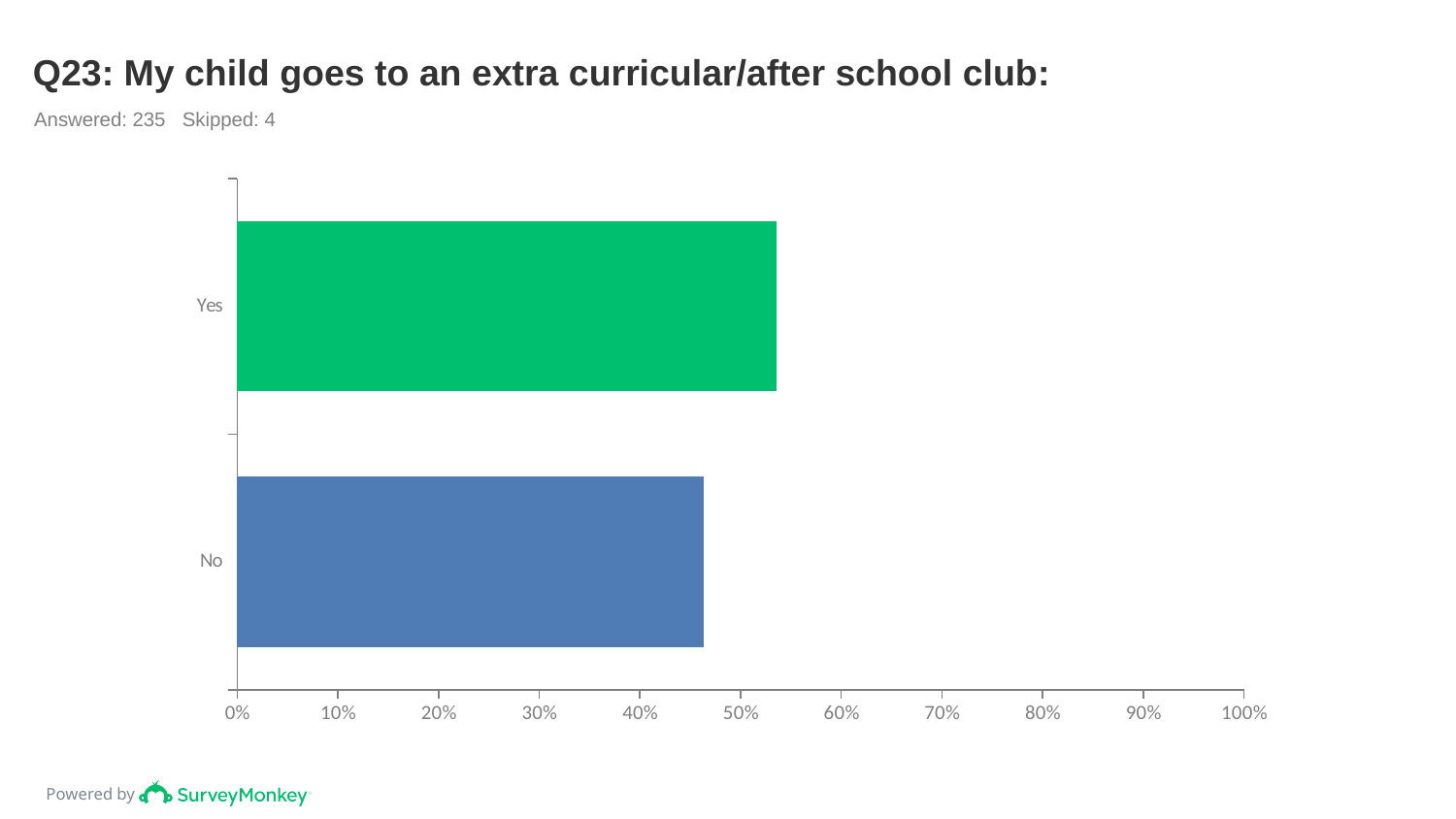
How many categories does the chart show? 2 What is the title of the chart? Q23: My child goes to an extra curricular/after school club: Which category has the highest value? Yes What kind of chart is shown on the slide? bar chart Is the value for No greater or less than 40%? greater Is the value for No greater or less than 50%? less Which is larger, the value for Yes or the value for No? Yes What colour is the bar for Yes? green Is the value for Yes greater or less than 50%? greater Which category has the lowest value? No